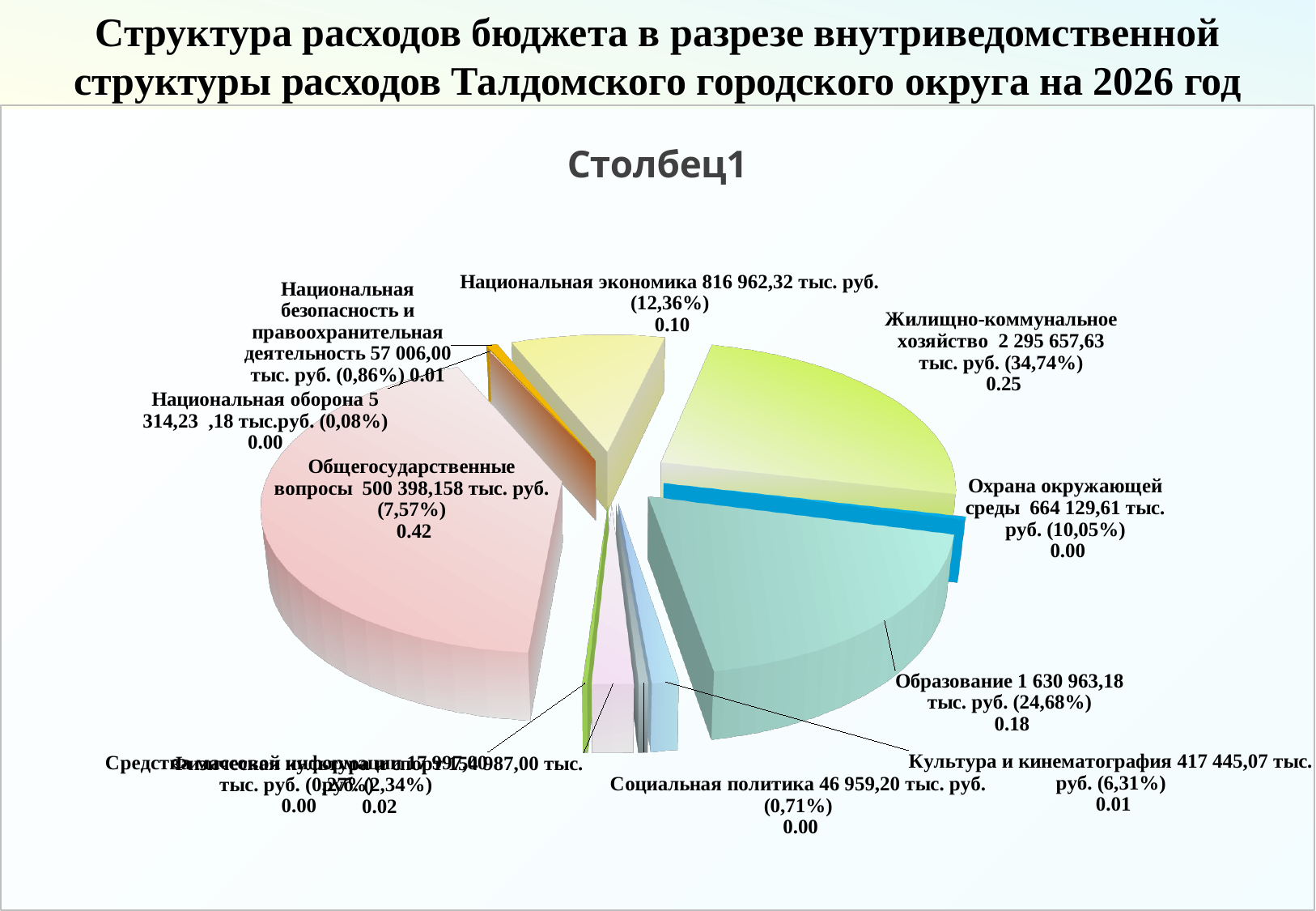
Which is larger: the share for Образование or the share for Национальная экономика? Образование What is the value for Охрана окружающей среды in тыс. руб.? 664 129,61 тыс. руб. What kind of chart is shown on the slide? pie chart What is the difference in percentage points between the shares of Жилищно-коммунальное хозяйство and Образование? 10,06 What is the value for Образование in тыс. руб.? 1 630 963,18 тыс. руб. What share of the budget does Жилищно-коммунальное хозяйство account for? 34,74% What percentage is shown for Социальная политика? 0,71% What is the title shown above the chart? Столбец1 What is the value for Культура и кинематография in тыс. руб.? 417 445,07 тыс. руб. What percentage is shown for Национальная экономика? 12,36%